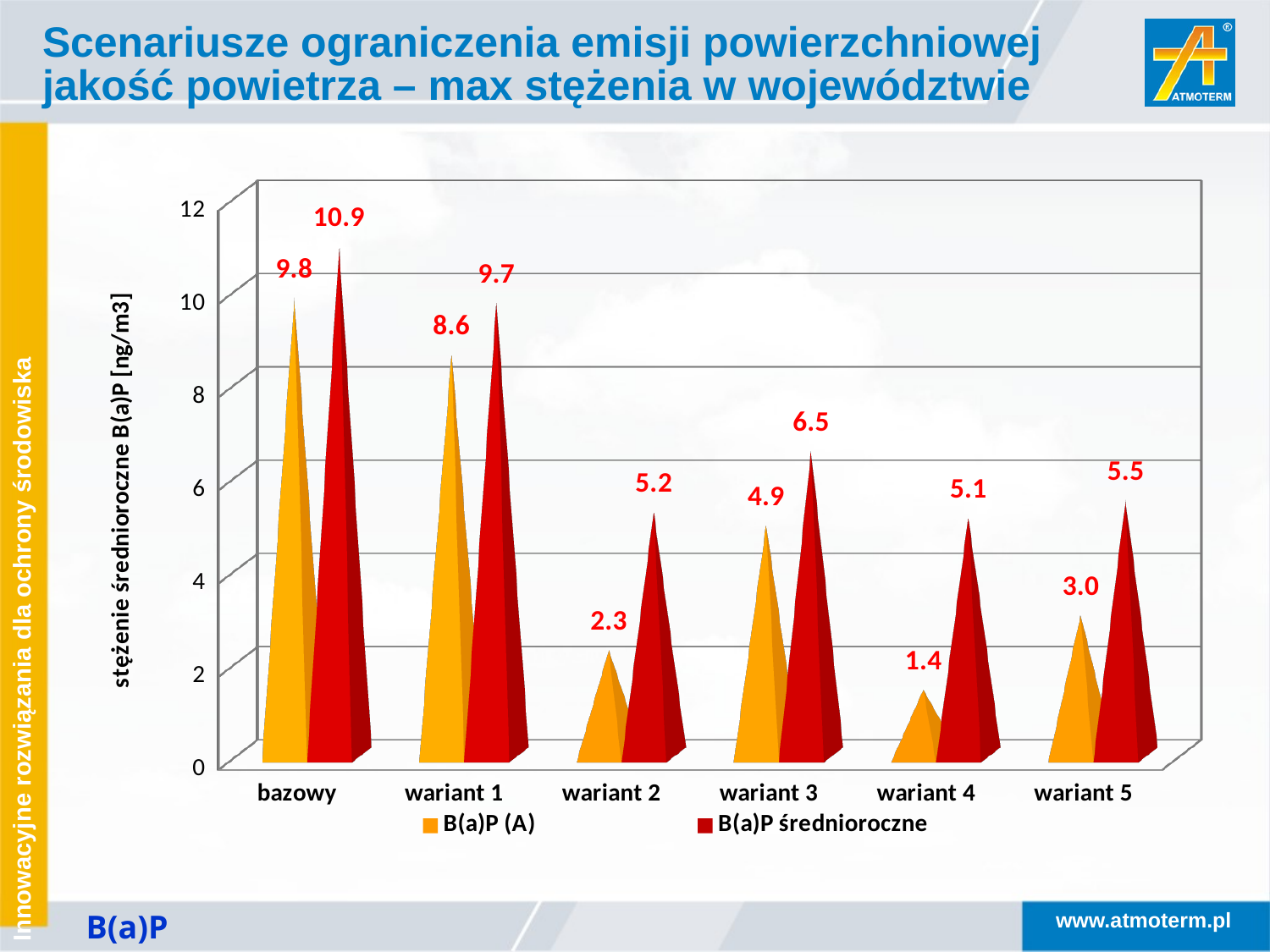
Which is larger: the B(a)P (A) value for wariant 3 or for wariant 5? wariant 3 What is the difference between the B(a)P średnioroczne and B(a)P (A) values for wariant 5? 2.5 How many series does the legend list? 2 Which category has the lowest B(a)P średnioroczne value? wariant 4 What is the B(a)P średnioroczne value for wariant 3? 6.5 What kind of chart is shown on the slide? bar chart What is the B(a)P (A) value for wariant 4? 1.4 What is the B(a)P (A) value for wariant 2? 2.3 How many categories are shown on the x axis? 6 Which category has the highest B(a)P (A) value? bazowy What is the label of the y axis? stężenie średnioroczne B(a)P [ng/m3] What is the B(a)P średnioroczne value for bazowy? 10.9